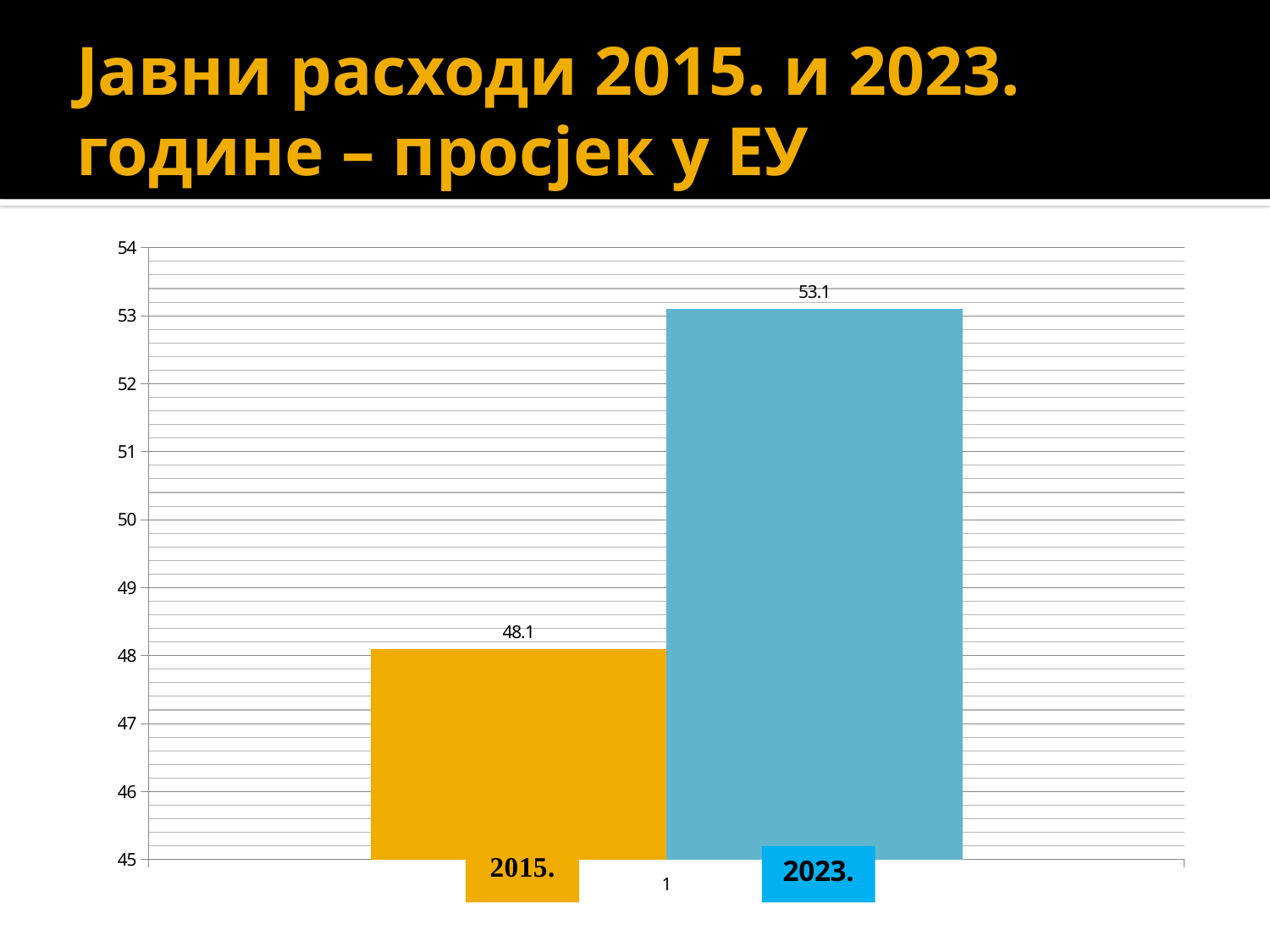
Which year has the lower value? 2015 What is the value shown for 2015? 48.1 Is the value for 2015 greater or less than 49? less What colour is the bar for 2023? blue What kind of chart is shown on the slide? bar chart How many bars are plotted on the chart? 2 What is the value shown for 2023? 53.1 Is the value for 2015 larger or smaller than the value for 2023? smaller Is the value for 2023 greater or less than 50? greater Do the values rise or fall from 2015 to 2023? rise Which year has the higher value, 2015 or 2023? 2023 What is the difference between the 2023 value and the 2015 value? 5